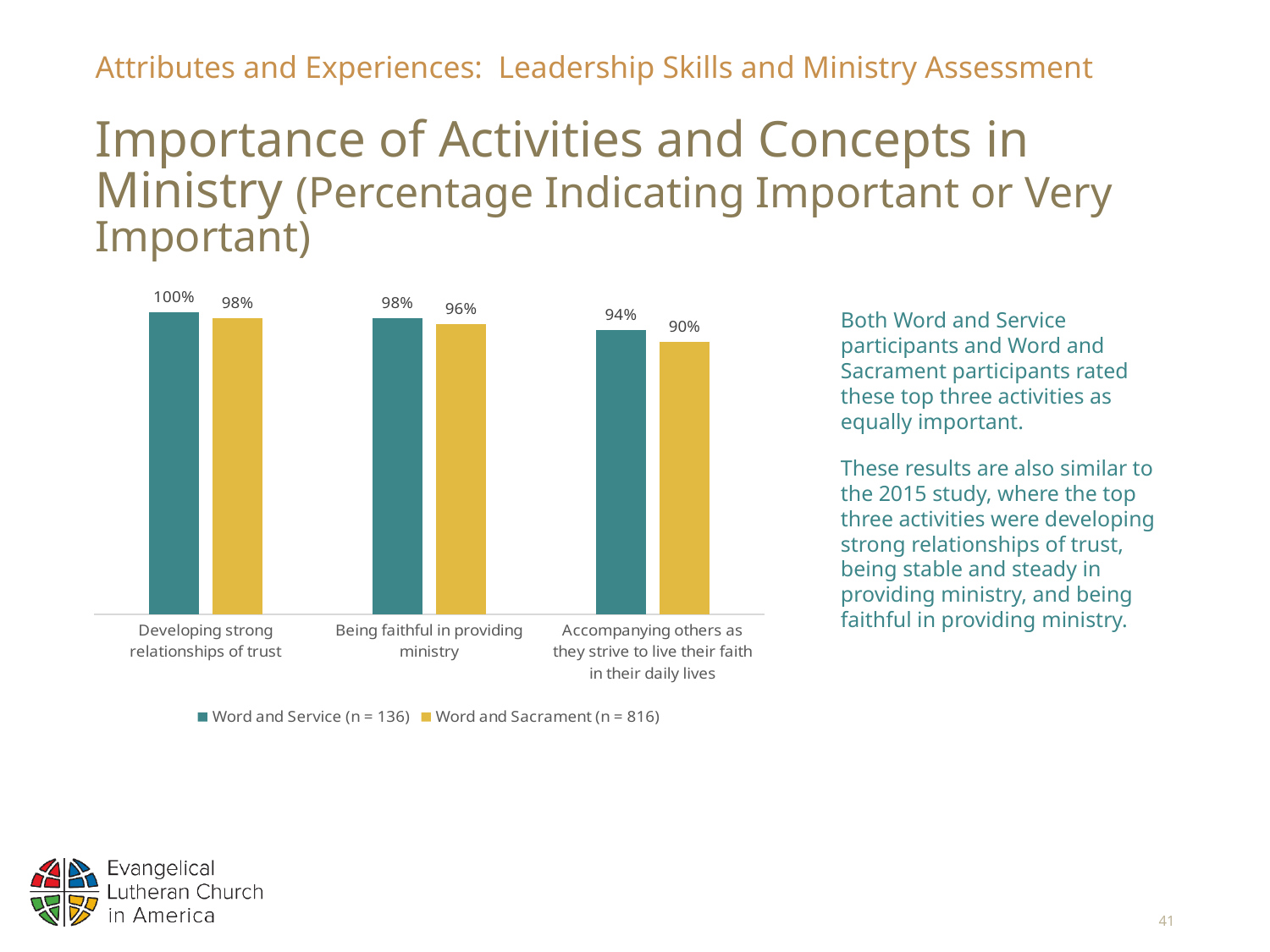
What is the difference between the Word and Service values for 'Developing strong relationships of trust' and 'Accompanying others as they strive to live their faith in their daily lives'? 6% What is the value for Word and Sacrament for 'Developing strong relationships of trust'? 98% For 'Being faithful in providing ministry', which group has the higher value: Word and Service or Word and Sacrament? Word and Service What is the value for Word and Service for 'Being faithful in providing ministry'? 98% How many activities are shown on the x axis of the chart? 3 What is the value for Word and Sacrament for 'Accompanying others as they strive to live their faith in their daily lives'? 90% What is the difference between the Word and Service and Word and Sacrament values for 'Accompanying others as they strive to live their faith in their daily lives'? 4% Which activity has the lowest value for Word and Sacrament? Accompanying others as they strive to live their faith in their daily lives How many series does the legend list? 2 What percentage of Word and Service participants rated 'Developing strong relationships of trust' as important or very important? 100% What type of chart is shown on the slide? Bar chart Which activity has the highest value for Word and Service? Developing strong relationships of trust